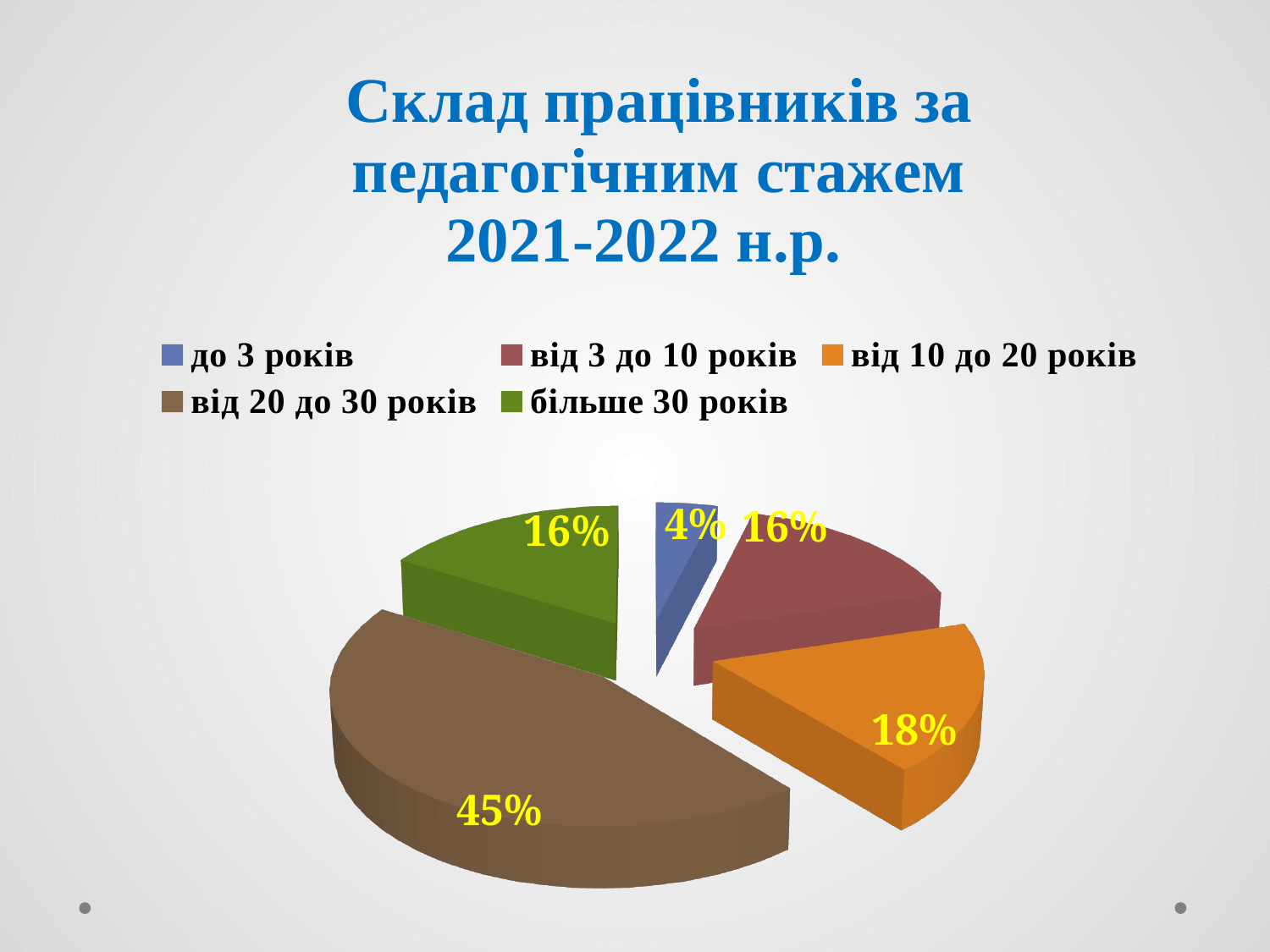
What share of the pie does the slice for "до 3 років" represent? 4% Which is larger: the share for "від 10 до 20 років" or the share for "від 3 до 10 років"? від 10 до 20 років Which category has the smallest slice of the pie? до 3 років What share of the pie does the slice for "від 3 до 10 років" represent? 16% What share of the pie does the slice for "від 20 до 30 років" represent? 45% What kind of chart is shown on the slide? pie chart Which category has the largest slice of the pie? від 20 до 30 років How many categories does the legend list? 5 What is the difference between the shares for "від 20 до 30 років" and "від 10 до 20 років"? 27% What colour is the slice for "більше 30 років"? green